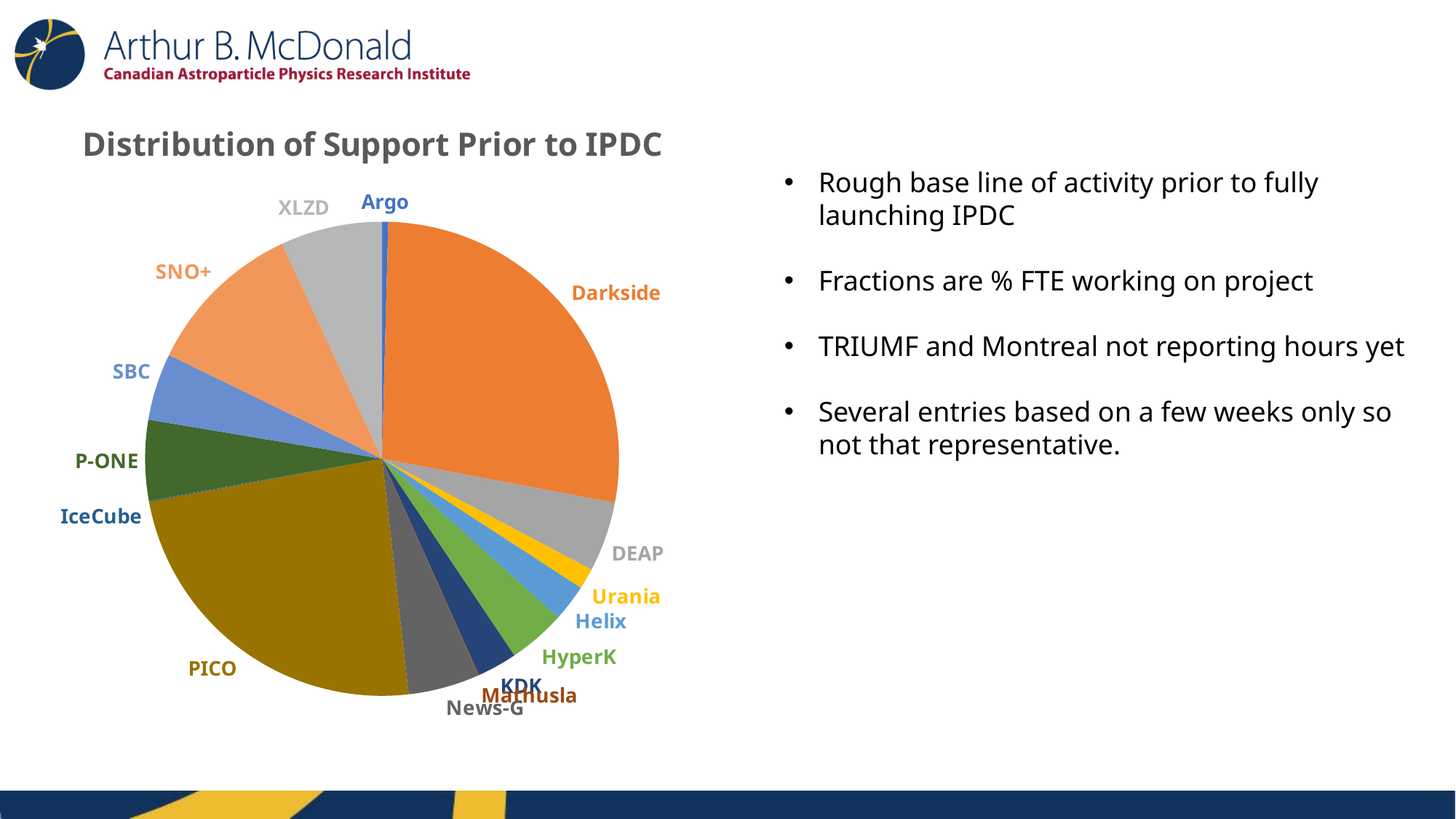
Which slice is larger, SNO+ or SBC? SNO+ Which slice is larger, Darkside or SNO+? Darkside How many labelled slices does the pie chart have? 15 What kind of chart is shown on the slide? pie chart What is the title of the chart? Distribution of Support Prior to IPDC Which slice is larger, HyperK or Argo? HyperK Which project has the largest slice of the pie? Darkside What colour is the Darkside slice? orange